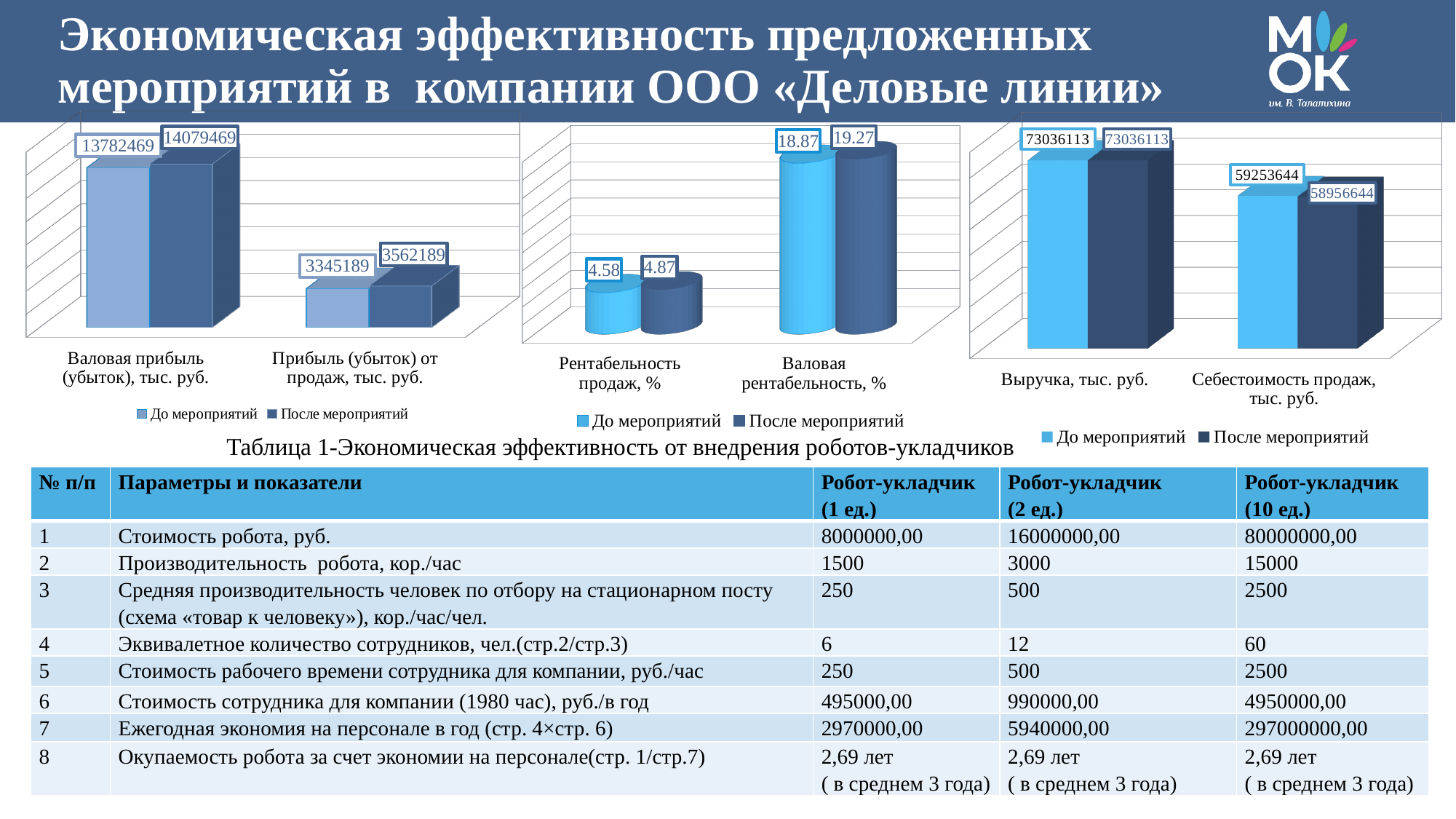
In the left chart, what is the value of 'Валовая прибыль (убыток), тыс. руб.' for 'До мероприятий'? 13782469 In the right chart, what is the difference between the 'До мероприятий' and 'После мероприятий' values for 'Себестоимость продаж, тыс. руб.'? 297000 In the right chart, what is the value of 'Выручка, тыс. руб.' for 'До мероприятий'? 73036113 What type of chart is the right chart? Bar chart In the right chart, what is the value of 'Себестоимость продаж, тыс. руб.' for 'После мероприятий'? 58956644 In the middle chart, what is the value of 'Рентабельность продаж, %' for 'После мероприятий'? 4.87 In the middle chart, what is the value of 'Валовая рентабельность, %' for 'До мероприятий'? 18.87 How many series does the legend of the left chart list? 2 In the left chart, what is the difference between the 'После мероприятий' and 'До мероприятий' values for 'Валовая прибыль (убыток), тыс. руб.'? 297000 In the middle chart, which category has the higher values, 'Рентабельность продаж, %' or 'Валовая рентабельность, %'? Валовая рентабельность, % In the left chart, what is the value of 'Прибыль (убыток) от продаж, тыс. руб.' for 'После мероприятий'? 3562189 How many categories are shown on the x axis of the middle chart? 2